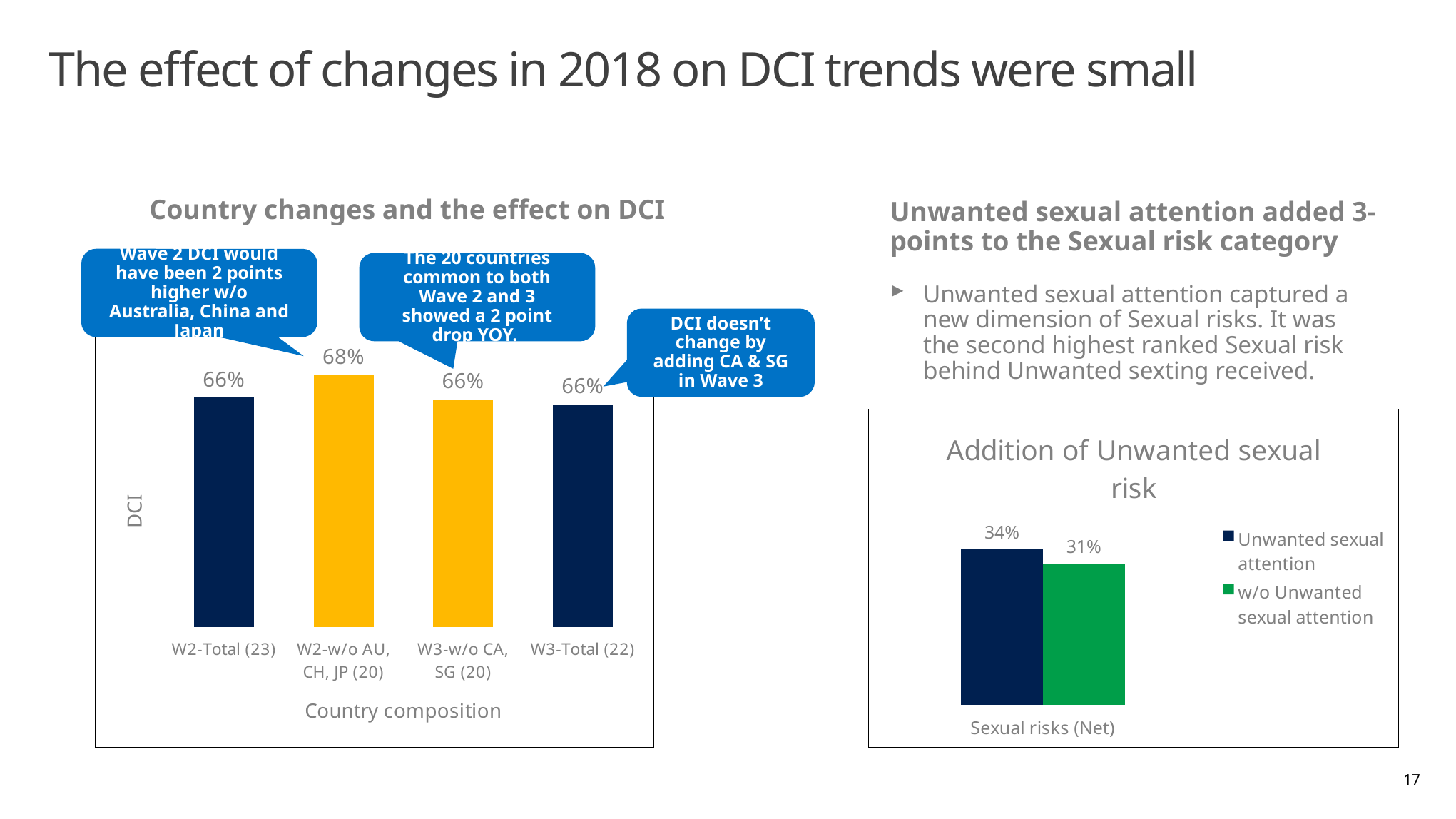
In the 'Country changes and the effect on DCI' chart, what is the difference between W2-w/o AU, CH, JP (20) and W3-w/o CA, SG (20)? 2 percentage points In the 'Country changes and the effect on DCI' chart, which category has the highest value? W2-w/o AU, CH, JP (20) How many series does the legend of the 'Addition of Unwanted sexual risk' chart list? 2 In the 'Country changes and the effect on DCI' chart, what is the x-axis title? Country composition In the 'Addition of Unwanted sexual risk' chart, which series is larger: Unwanted sexual attention or w/o Unwanted sexual attention? Unwanted sexual attention What kind of chart is 'Country changes and the effect on DCI'? Bar chart In the 'Country changes and the effect on DCI' chart, what is the value for W2-w/o AU, CH, JP (20)? 68% In the 'Country changes and the effect on DCI' chart, how many categories are shown on the x axis? 4 In the 'Addition of Unwanted sexual risk' chart, what is the value for w/o Unwanted sexual attention? 31% In the 'Country changes and the effect on DCI' chart, what is the value for W2-Total (23)? 66% In the 'Addition of Unwanted sexual risk' chart, what is the difference between the two series? 3 percentage points In the 'Addition of Unwanted sexual risk' chart, what is the value for Unwanted sexual attention? 34%